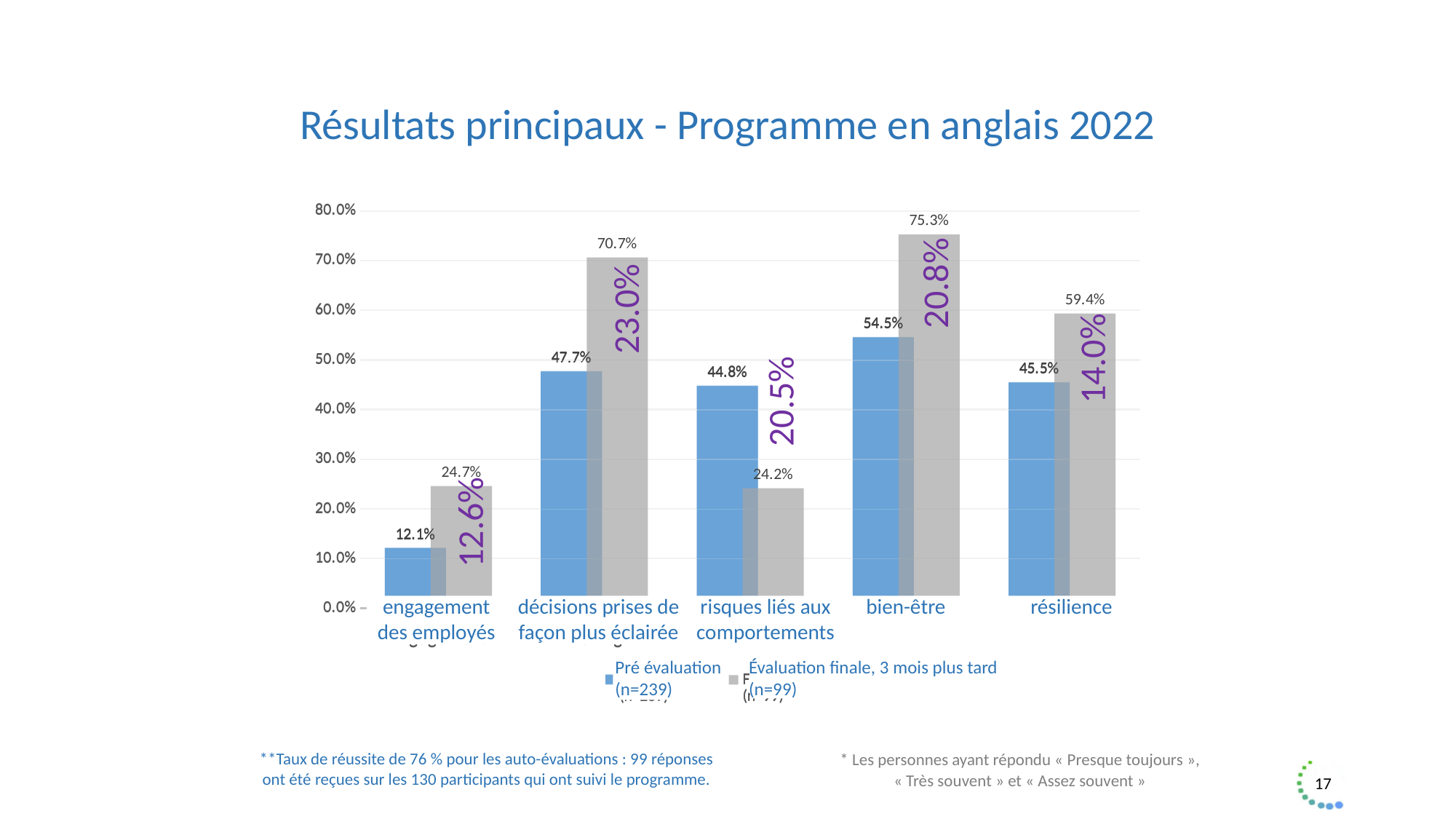
What is the Pré évaluation value for engagement des employés? 12.1% What type of chart is shown on the slide? bar chart What is the Évaluation finale value for bien-être? 75.3% What is the Évaluation finale value for résilience? 59.4% What is the Pré évaluation value for risques liés aux comportements? 44.8% Which category has the highest Évaluation finale value? bien-être How many categories are shown on the x axis? 5 Which is larger for risques liés aux comportements: the Pré évaluation value or the Évaluation finale value? Pré évaluation How many series does the legend list? 2 What is the title of the slide? Résultats principaux - Programme en anglais 2022 What is the difference between the Évaluation finale and Pré évaluation values for décisions prises de façon plus éclairée? 23.0% Which category has the lowest Pré évaluation value? engagement des employés